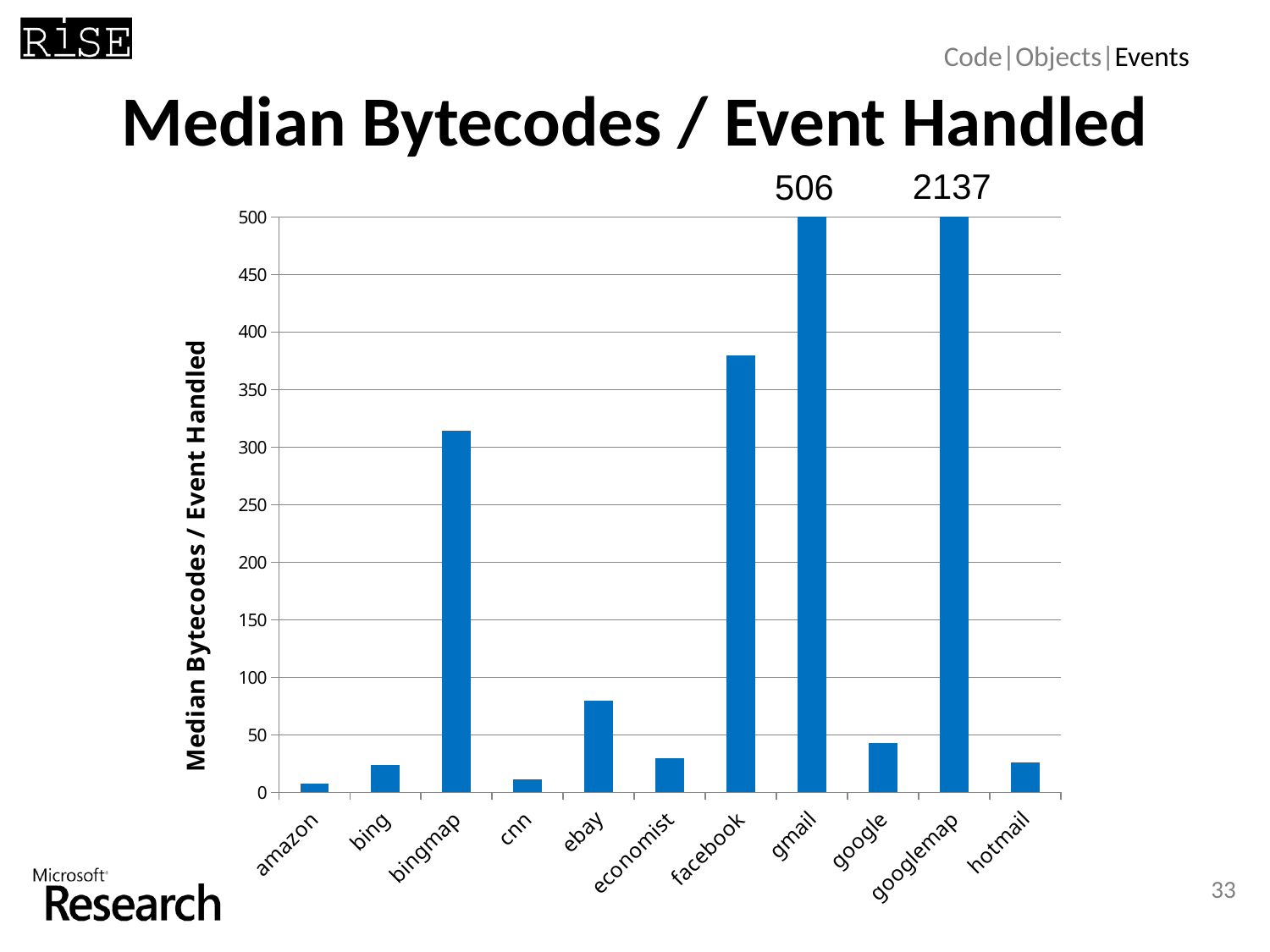
Is the value for facebook greater or less than 350? greater How many categories (websites) are plotted on the x axis? 11 What is the median bytecodes per event handled for googlemap? 2137 What is the label on the vertical axis of the chart? Median Bytecodes / Event Handled What is the median bytecodes per event handled for gmail? 506 What kind of chart is shown on the slide? bar chart Is the value for google greater or less than 50? less Which has a larger value, ebay or economist? ebay What is the difference between the values for googlemap and gmail? 1631 Which has a larger value, facebook or bingmap? facebook Which website has the highest median bytecodes per event handled? googlemap Is the value for bingmap greater or less than 300? greater